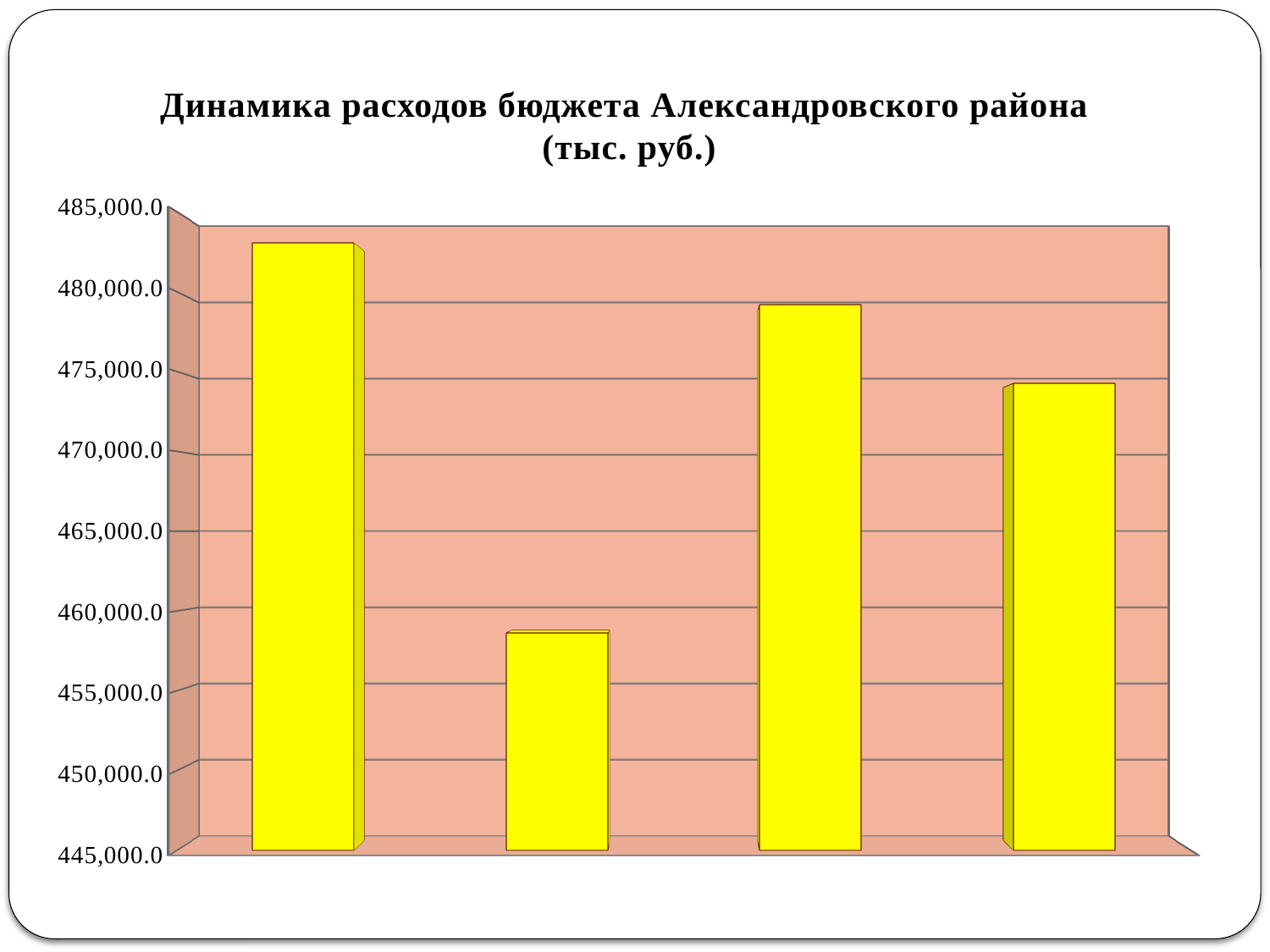
Is the value of the third bar greater or less than 475,000.0? greater Is the value of the first bar greater or less than 480,000.0? greater What is the highest value shown on the vertical axis? 485,000.0 What is the title of the chart? Динамика расходов бюджета Александровского района (тыс. руб.) Which is larger, the value of the third bar or the value of the fourth bar? the third bar Is the value of the fourth bar greater or less than 470,000.0? greater Which bar is the shortest? the second bar What kind of chart is shown on the slide? bar chart Does the value rise or fall from the first bar to the second bar? fall Which bar is the tallest? the first bar How many bars are plotted in the chart? 4